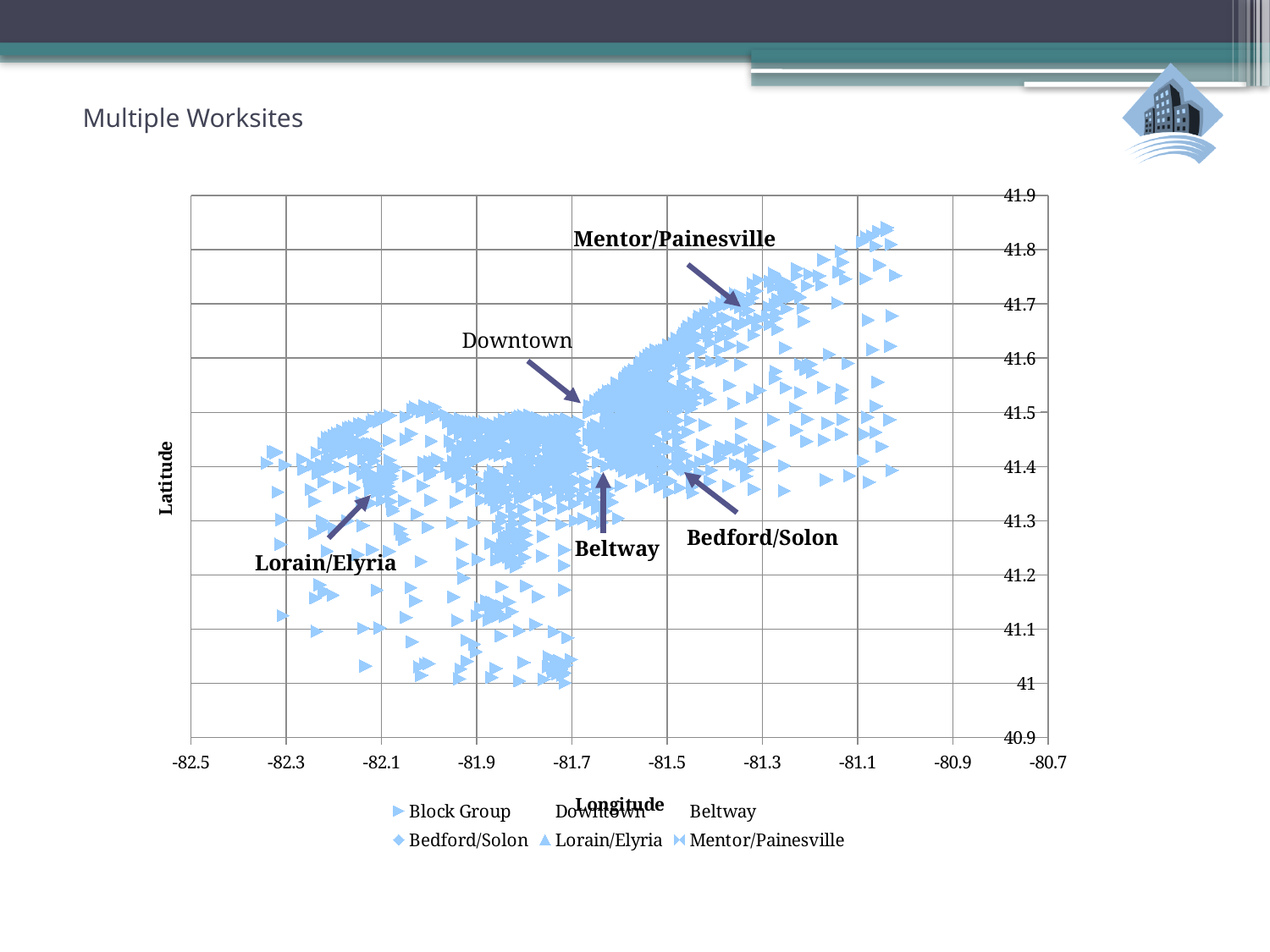
Which labelled worksite has the higher latitude, Mentor/Painesville or Beltway? Mentor/Painesville What is the label of the vertical axis? Latitude How many series does the legend list? 6 How many worksites are labelled with arrows on the chart? 5 Is the latitude of the Mentor/Painesville worksite greater or less than 41.6? greater What kind of chart is shown on the slide? Scatter chart What is the label of the horizontal axis? Longitude Which labelled worksite is furthest west (lowest longitude)? Lorain/Elyria Which labelled worksite has the highest latitude? Mentor/Painesville Is the latitude of the Downtown worksite greater or less than 41.4? greater Is the latitude of the Mentor/Painesville worksite greater or less than 41.8? less